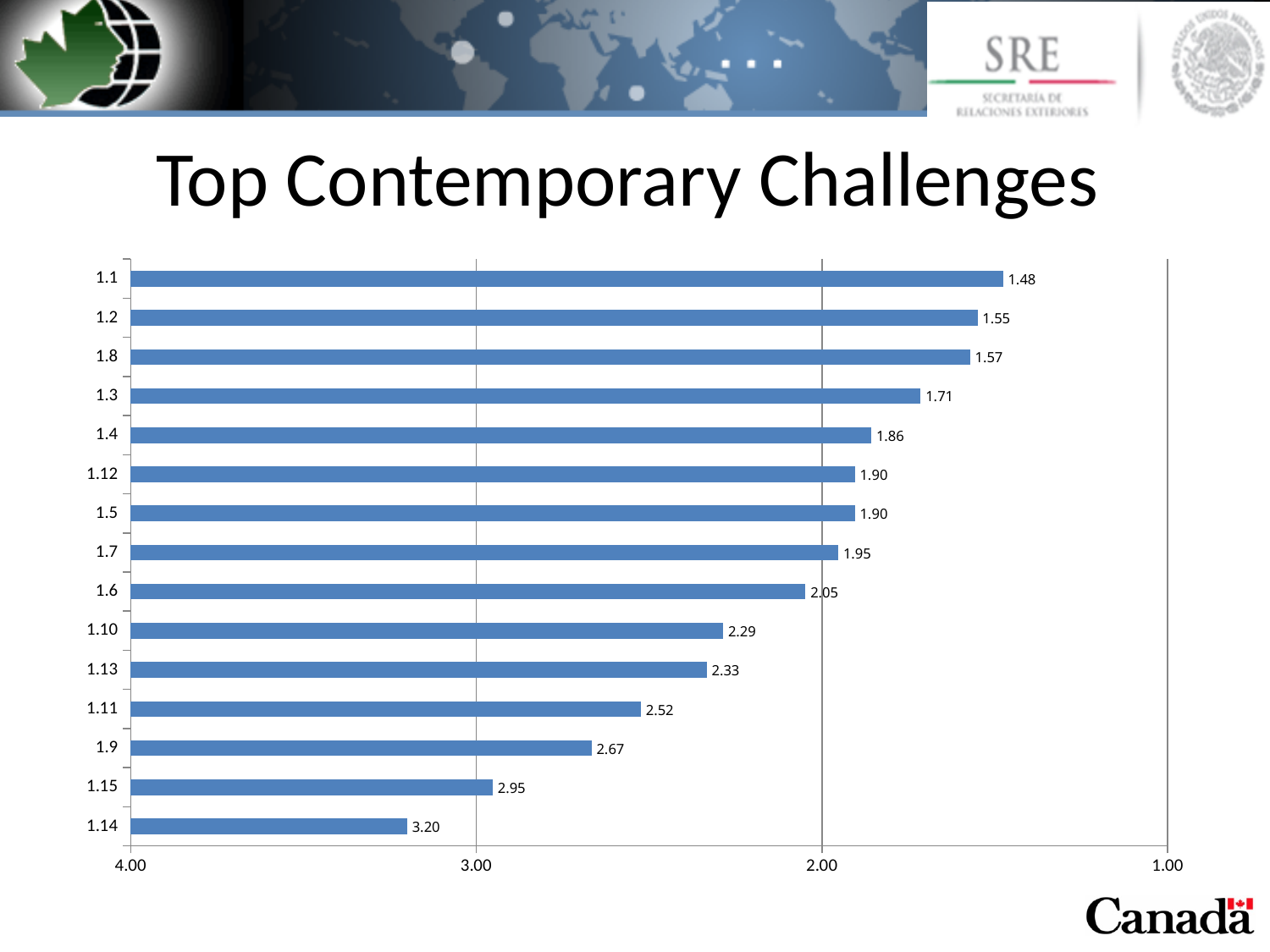
What is the difference between the values for 1.15 and 1.9? 0.28 What is the value for category 1.11? 2.52 Which has the larger value, 1.13 or 1.3? 1.13 What is the value for category 1.1? 1.48 What kind of chart is shown on the slide? Bar chart What is the title of the chart? Top Contemporary Challenges Which category has the highest value? 1.14 What is the value for category 1.14? 3.20 Which category has the lowest value? 1.1 How many categories are shown in the chart? 15 Is the value for 1.9 greater or less than 2.00? greater What is the difference between the values for 1.14 and 1.1? 1.72